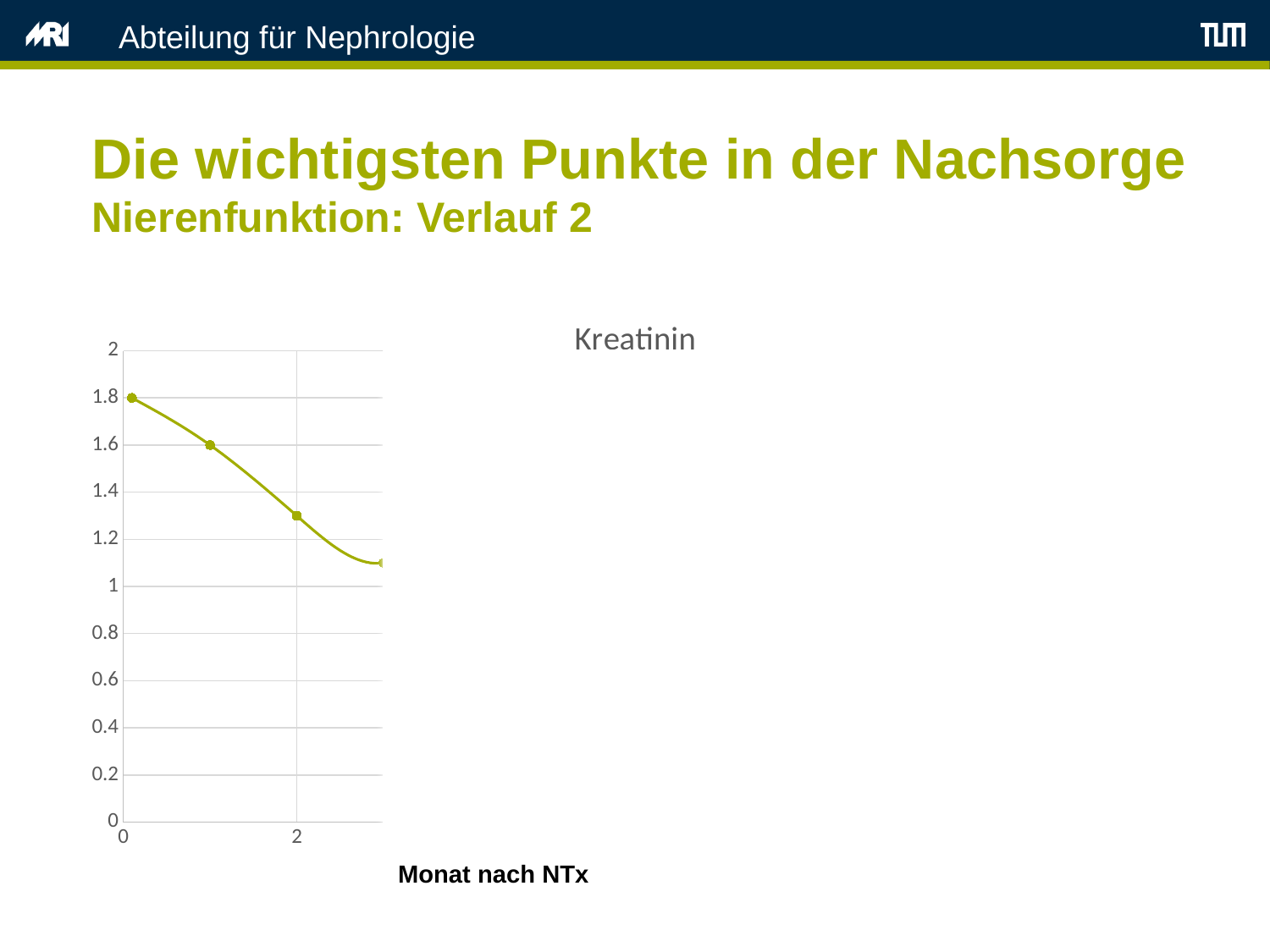
What is the Kreatinin value at month 0 (Monat nach NTx = 0)? 1.8 Is the Kreatinin value at month 2 greater or less than 1.2? greater Which is larger, the Kreatinin value at month 0 or at month 2? month 0 Is the Kreatinin value at month 2 greater or less than 1.4? less What is the label of the x axis of the chart? Monat nach NTx At which month is the Kreatinin value highest? 0 Is the Kreatinin value at the second point of the line greater or less than 1.4? greater What is the title of the chart? Kreatinin What kind of chart is shown on the slide? line chart Do the Kreatinin values rise or fall along the x axis? fall